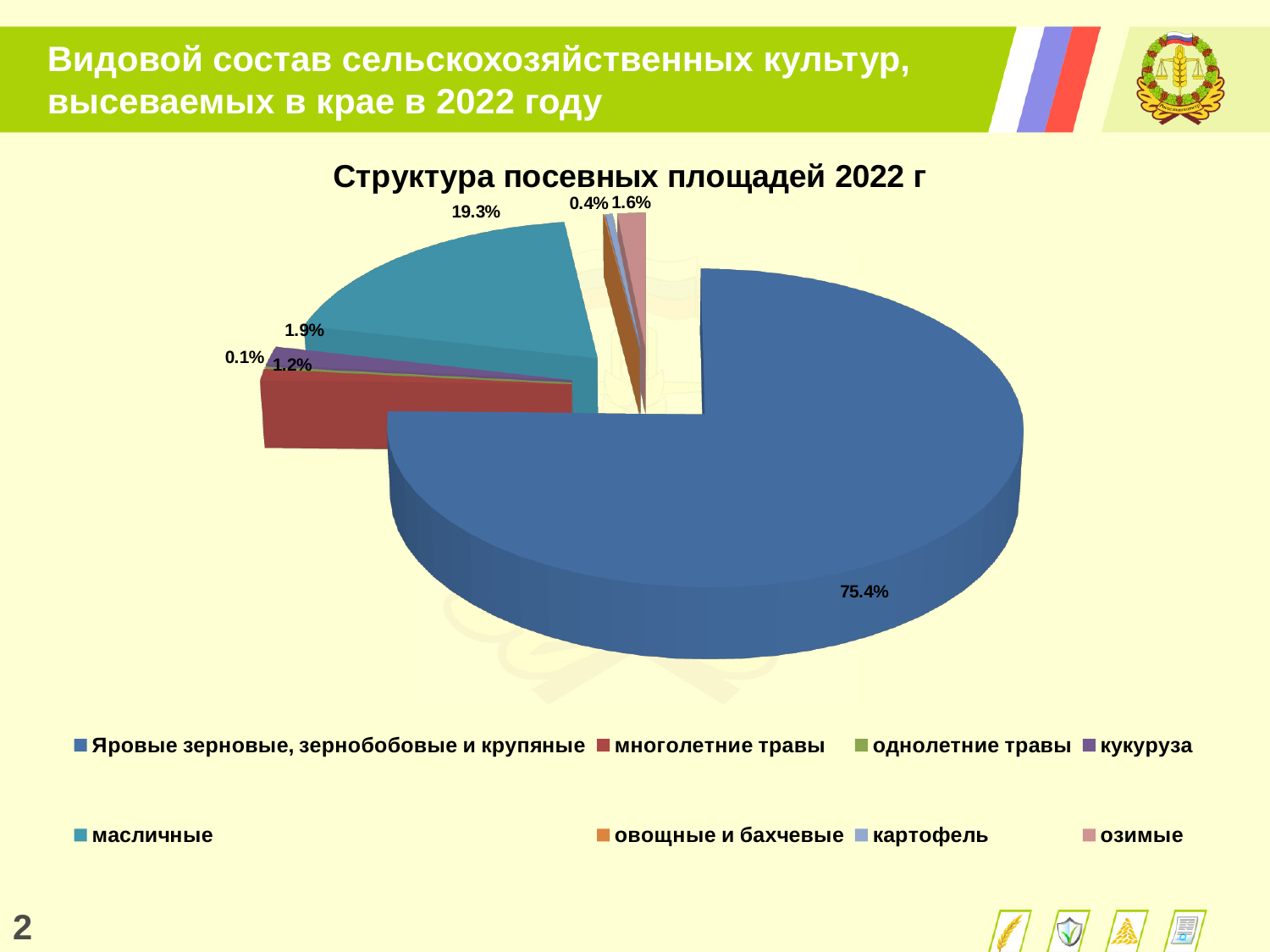
What is the value shown for 'озимые'? 1.6% What is the title of the chart? Структура посевных площадей 2022 г What share of the pie does 'масличные' have? 19.3% How many categories does the legend of the pie chart list? 8 Which is larger, the share for 'кукуруза' or the share for 'озимые'? кукуруза What is the difference between the share for 'Яровые зерновые, зернобобовые и крупяные' and the share for 'масличные'? 56.1% What is the value shown for 'многолетние травы'? 1.2% What share of the pie does 'Яровые зерновые, зернобобовые и крупяные' have? 75.4% What kind of chart is shown on the slide? pie chart Which category has the largest share of the pie? Яровые зерновые, зернобобовые и крупяные What is the value shown for 'кукуруза'? 1.9%